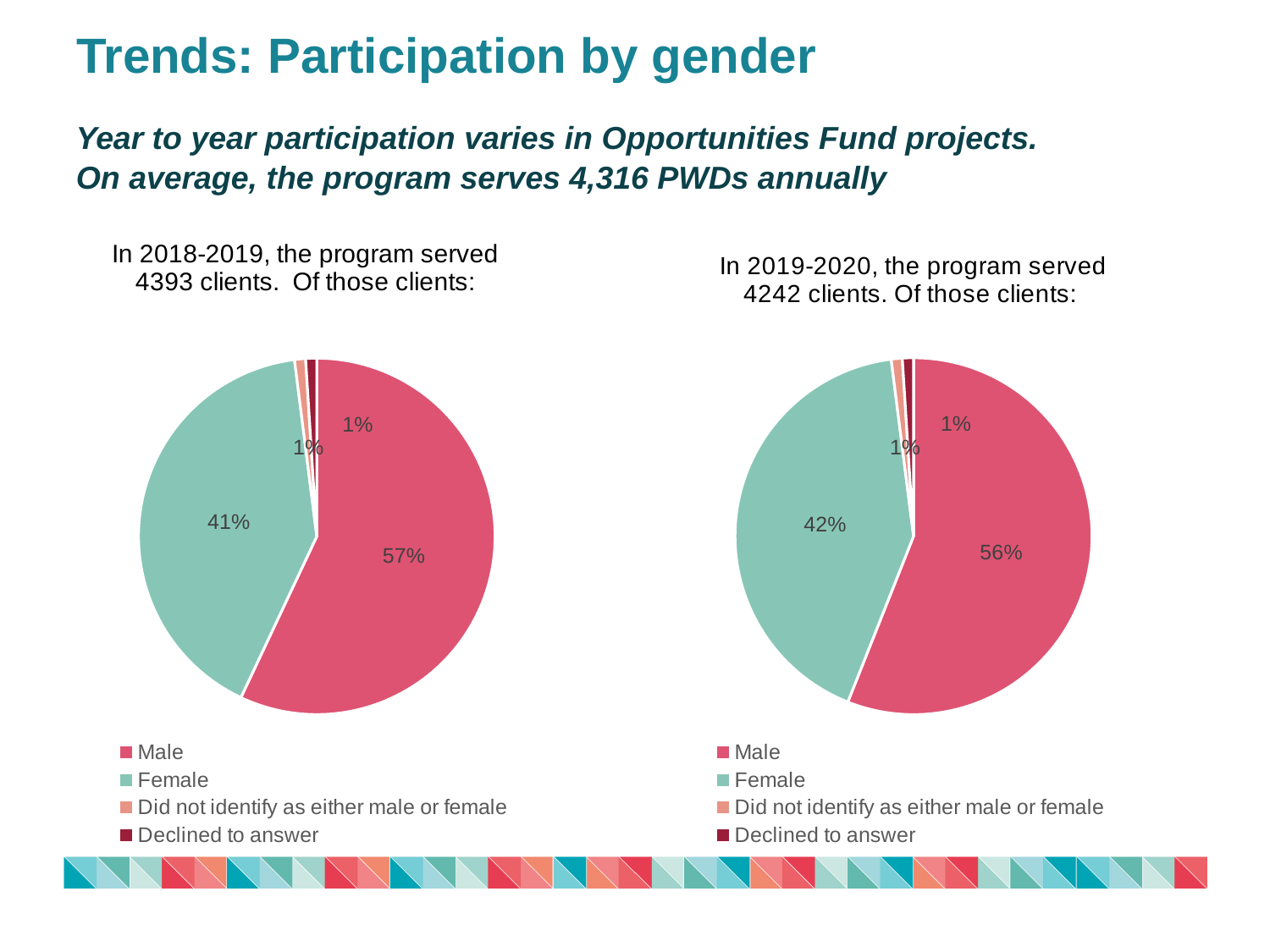
How many categories does the legend of the 2018-2019 chart list? 4 What kind of chart is used for the 2019-2020 data? Pie chart In the 2019-2020 pie chart, what colour is the Female slice? Teal (green) In the 2018-2019 pie chart, what share of clients were male? 57% In the 2019-2020 pie chart, what share of clients were female? 42% In the 2018-2019 pie chart, what is the difference between the Male and Female shares? 16% In the 2019-2020 pie chart, which is larger, the Male slice or the Female slice? Male In the 2018-2019 pie chart, what share of clients were female? 41% In the 2018-2019 pie chart, which category has the largest slice? Male In the 2019-2020 pie chart, what is the difference between the Male and Female shares? 14%